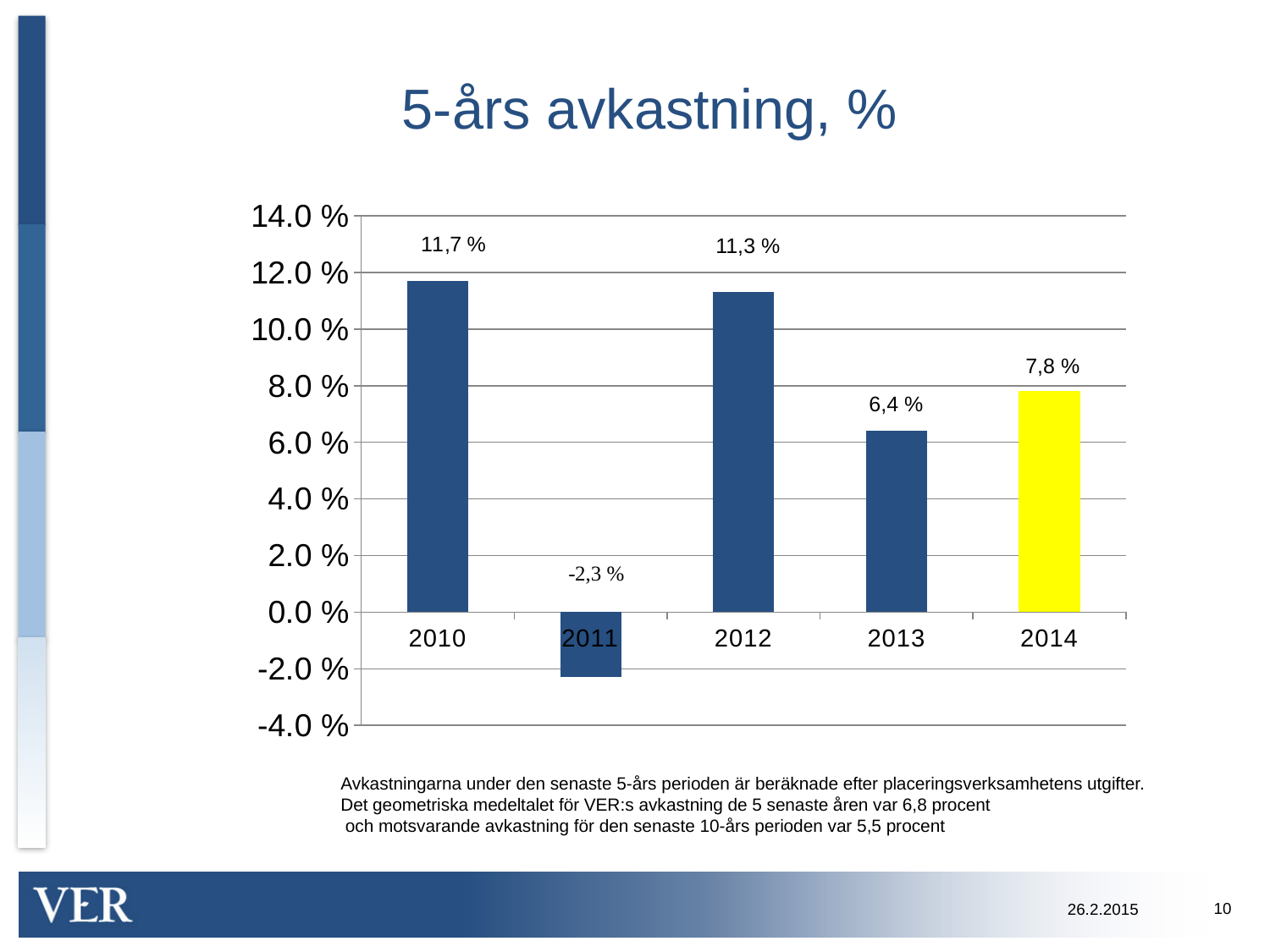
What is the value for 2010? 11,7 % Which year has the highest value? 2010 What is the title of the chart? 5-års avkastning, % What is the value for 2011? -2,3 % What is the difference between the values for 2014 and 2013? 1,4 % What is the value for 2014? 7,8 % Which year has the lowest value? 2011 Which is larger, the value for 2013 or the value for 2014? 2014 What is the difference between the values for 2010 and 2012? 0,4 % How many years are shown on the x axis? 5 What is the value for 2013? 6,4 % What kind of chart is shown? bar chart